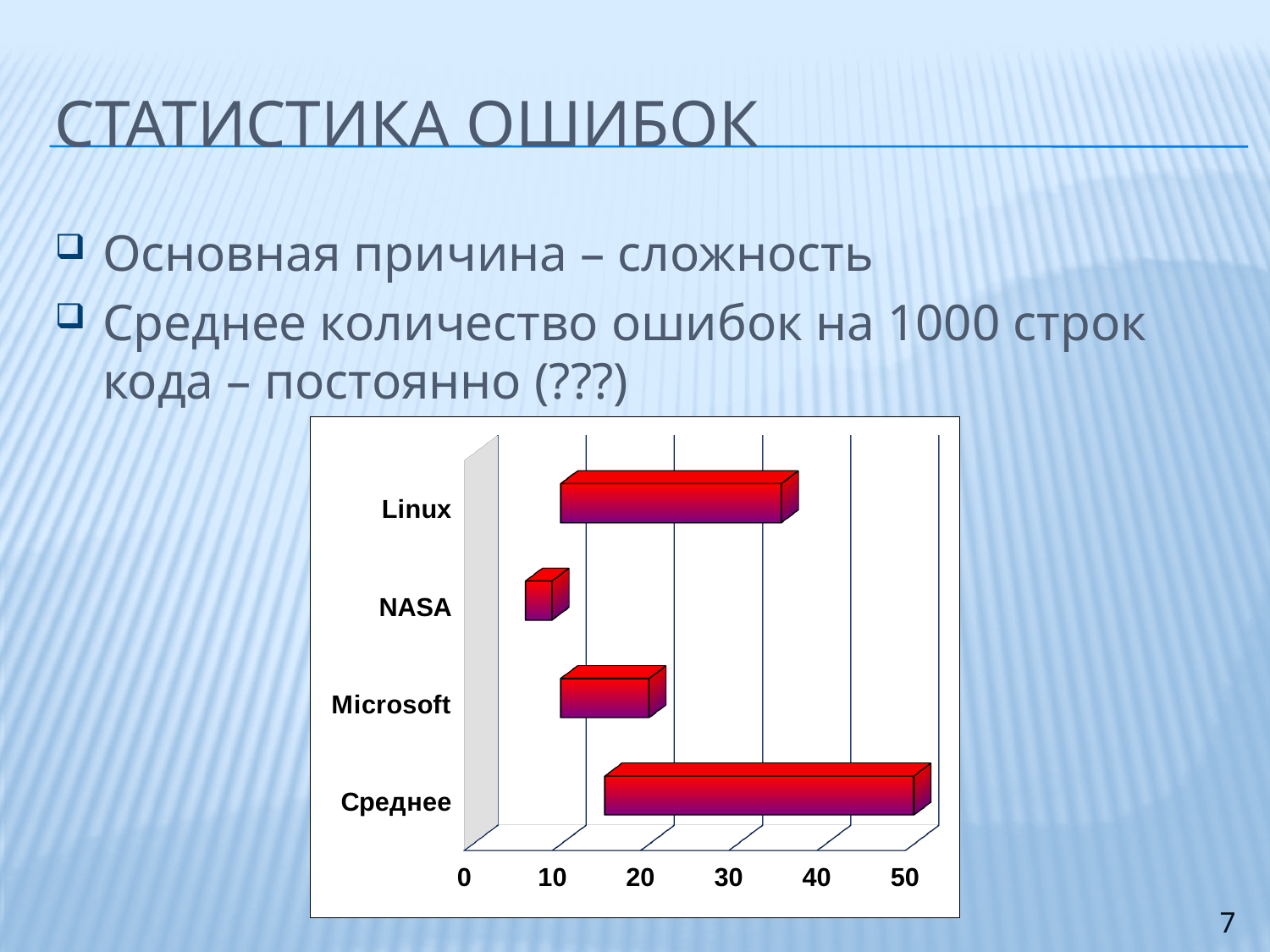
Which category has the lowest value in the chart? NASA Is the value for Linux greater or less than 20? greater What is the highest value shown on the chart's horizontal axis? 50 Which is larger, the value for Linux or the value for Microsoft? Linux What kind of chart is shown on the slide? bar chart Which category is listed at the top of the chart? Linux Is the value for Среднее greater or less than 40? greater Is the value for Microsoft greater or less than 30? less Which category has the highest value in the chart? Среднее How many categories are plotted in the chart? 4 Which is larger, the value for NASA or the value for Microsoft? Microsoft